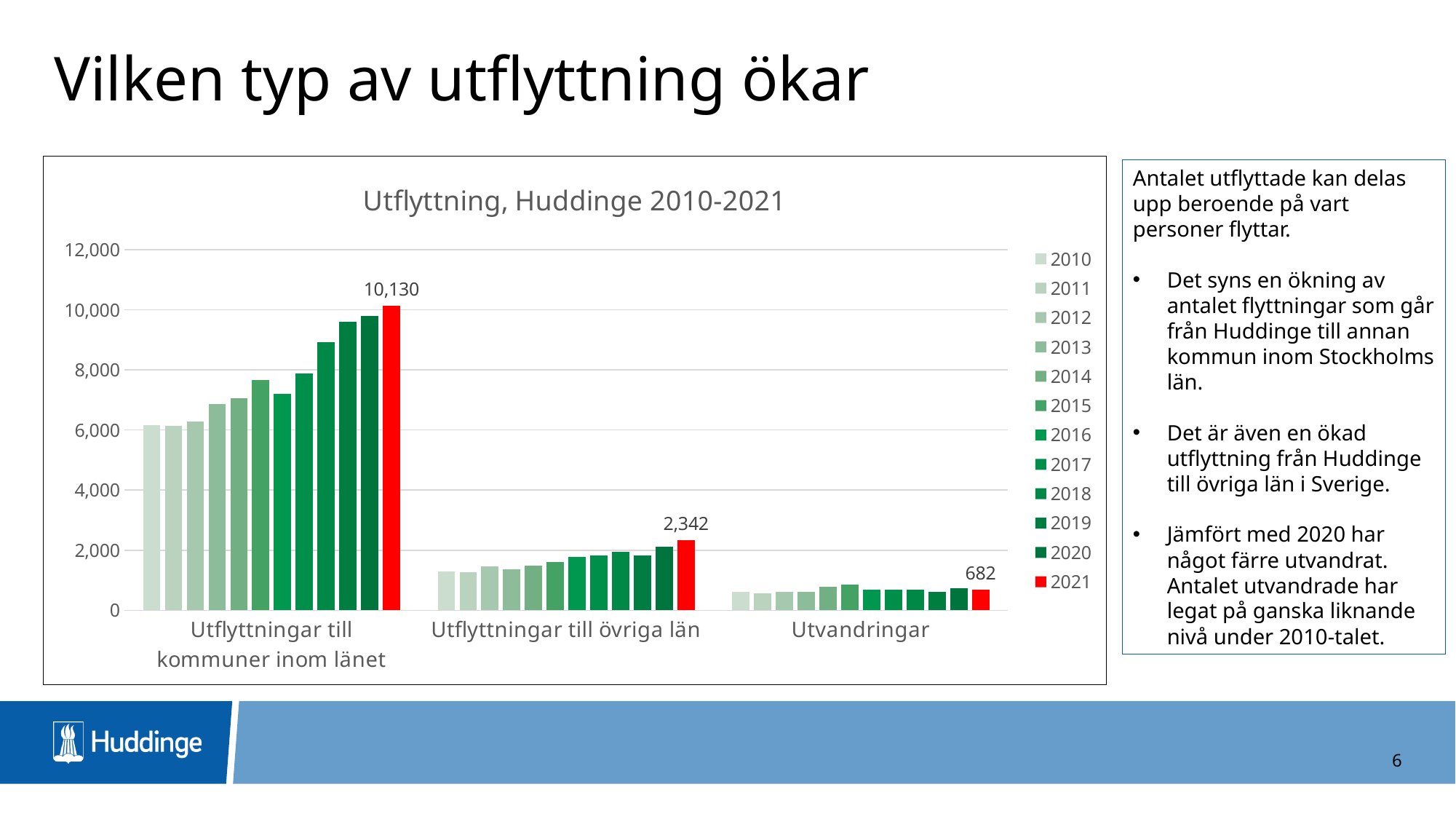
What kind of chart is shown? Bar chart Which category has the lowest value in 2021? Utvandringar What is the difference between the 2021 values for "Utflyttningar till övriga län" and "Utvandringar"? 1,660 What is the difference between the 2021 values for "Utflyttningar till kommuner inom länet" and "Utflyttningar till övriga län"? 7,788 What is the 2021 value for "Utflyttningar till kommuner inom länet"? 10,130 What is the 2021 value for "Utvandringar"? 682 How many series does the legend list? 12 What is the title of the chart? Utflyttning, Huddinge 2010-2021 Which category has the highest value in 2021? Utflyttningar till kommuner inom länet How many categories are shown on the x axis? 3 What is the 2021 value for "Utflyttningar till övriga län"? 2,342 Is the 2010 value for "Utflyttningar till kommuner inom länet" greater or less than 4,000? greater